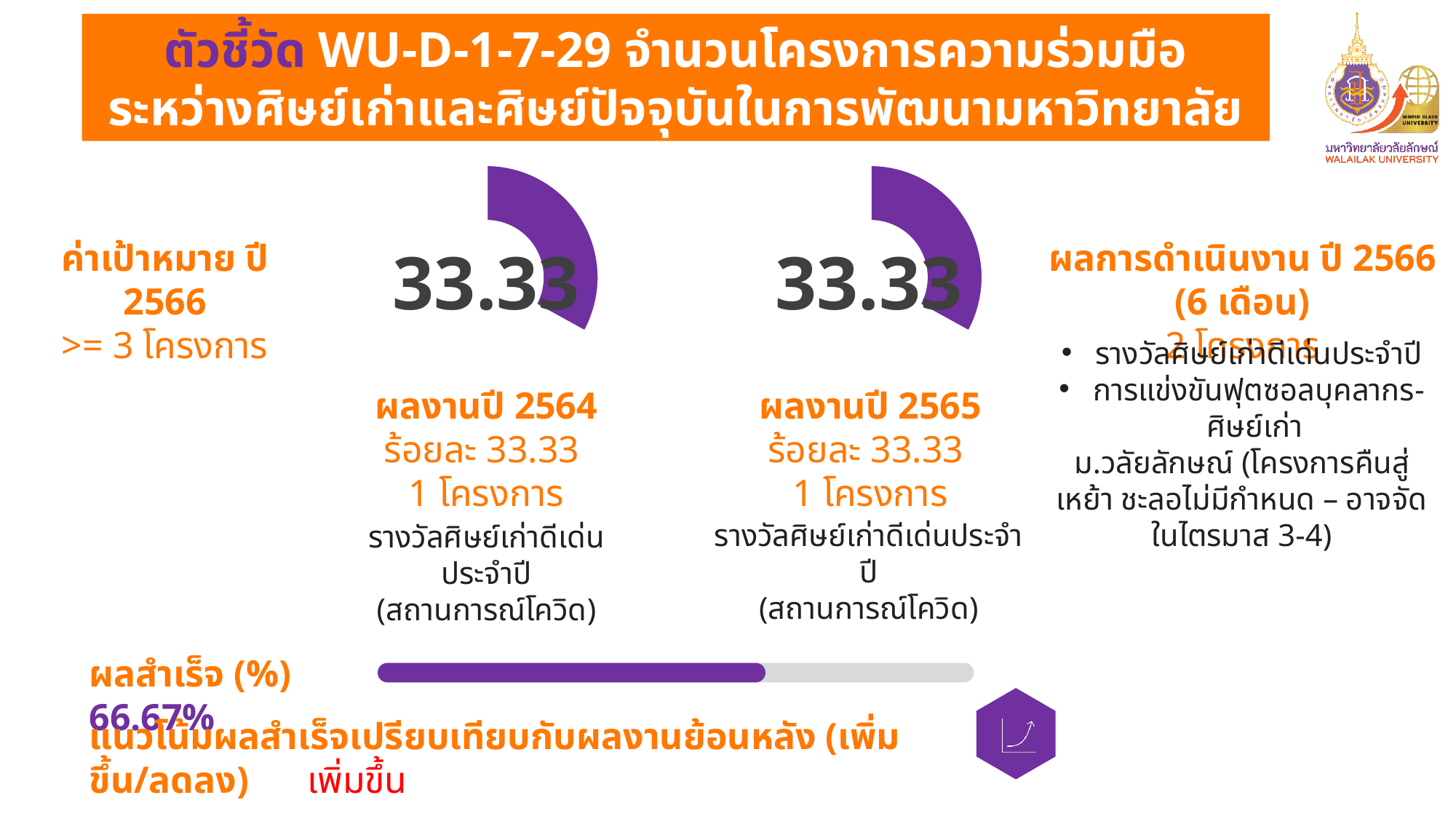
What is the target (ค่าเป้าหมาย) for year 2566 shown on the left of the slide? >= 3 โครงการ According to the slide, is the trend of ผลสำเร็จ compared with past performance increasing or decreasing? เพิ่มขึ้น What value is displayed in the right doughnut chart (ผลงานปี 2565)? 33.33 Are the values in the ผลงานปี 2564 and ผลงานปี 2565 doughnut charts equal? Yes, both are 33.33 What is the difference between the values shown in the ผลงานปี 2564 and ผลงานปี 2565 doughnut charts? 0 What colour is the filled portion of the doughnut charts and the progress bar? purple What percentage does the ผลสำเร็จ (%) progress bar at the bottom of the slide show? 66.67% How many projects (โครงการ) are reported under the ผลงานปี 2564 doughnut chart? 1 โครงการ Is the value shown by the ผลสำเร็จ (%) progress bar greater or less than 50%? greater How many doughnut charts are shown on the slide? 2 What kind of chart is used to show the values for ผลงานปี 2564 and ผลงานปี 2565? doughnut chart What value is displayed in the left doughnut chart (ผลงานปี 2564)? 33.33